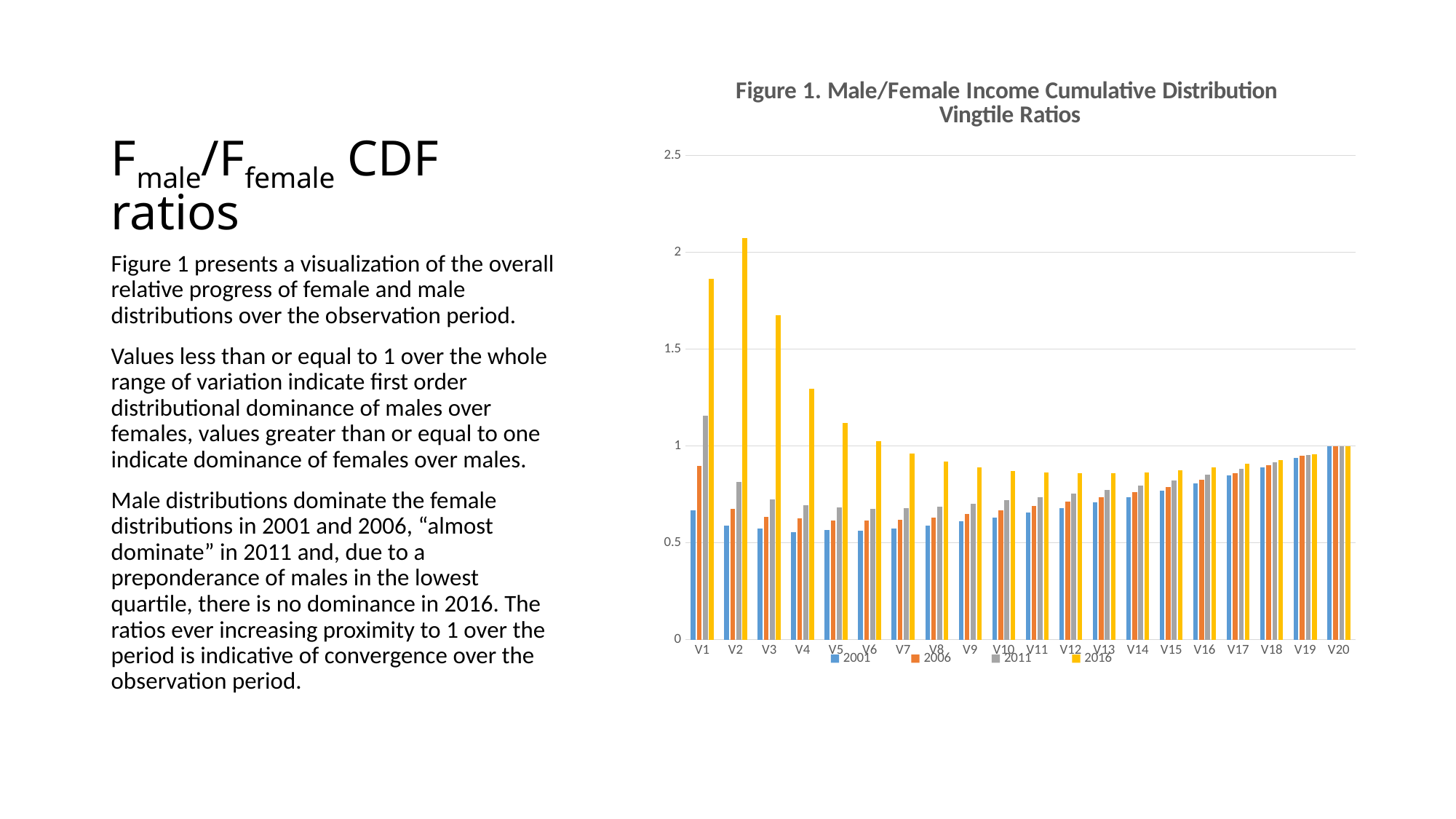
What kind of chart is shown on the slide? bar chart Is the 2016 value for V4 greater or less than 1? greater Which series has the highest value at V1? 2016 What is the title of the chart? Figure 1. Male/Female Income Cumulative Distribution Vingtile Ratios Do the 2001 values generally rise or fall from V1 to V20? rise How many series does the legend list? 4 How many categories are shown on the x axis? 20 Which category has the highest 2016 value? V2 Is the 2001 value for V1 greater or less than 1? less Is the 2016 value for V1 greater or less than 1.5? greater Which series does the legend list last? 2016